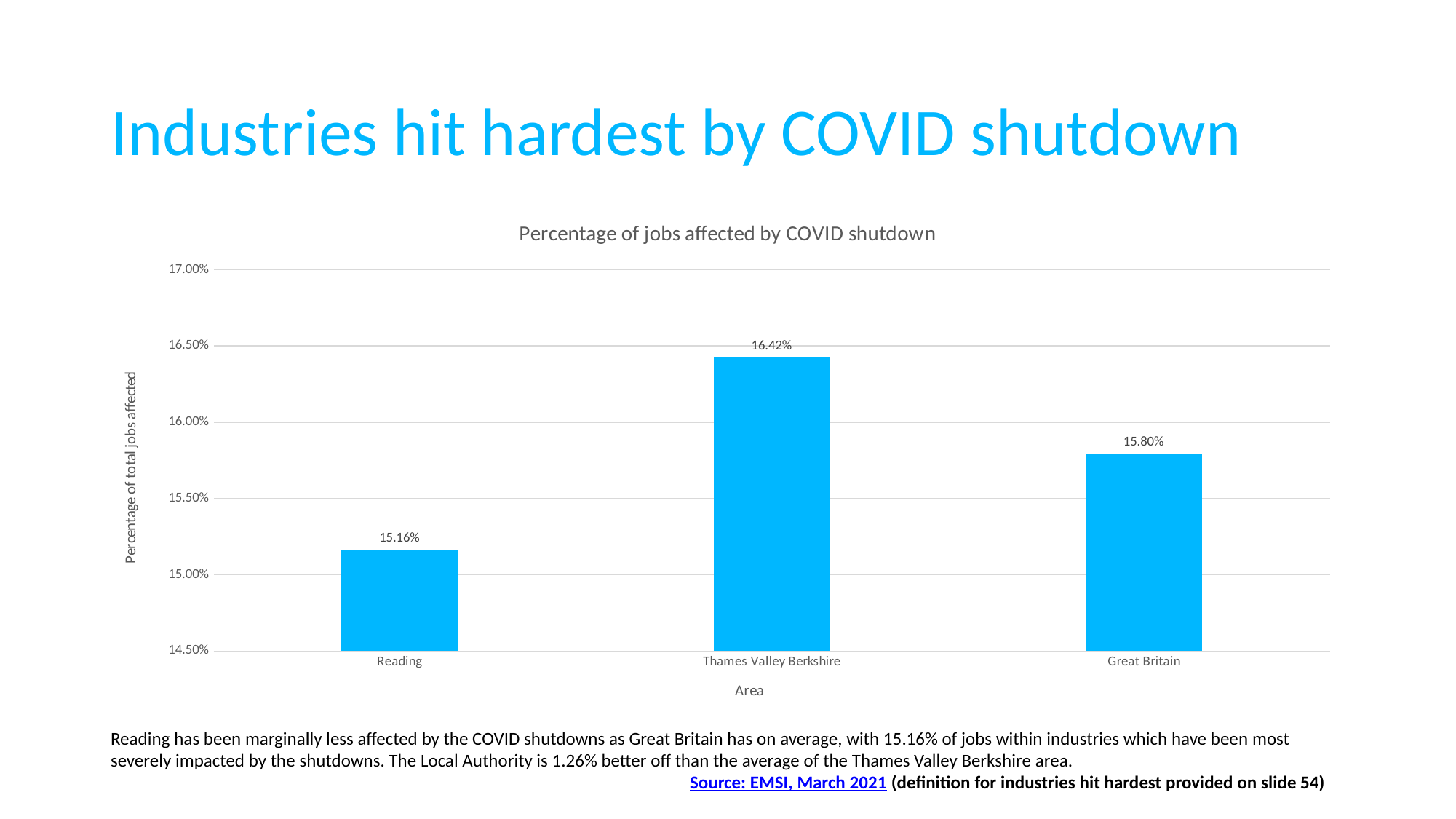
What is the title of the chart? Percentage of jobs affected by COVID shutdown What is the value for Great Britain? 15.80% What kind of chart is shown? Bar chart What is the difference between the values for Thames Valley Berkshire and Reading? 1.26% What is the value for Thames Valley Berkshire? 16.42% Which is larger, the value for Great Britain or the value for Reading? Great Britain How many areas are shown on the chart? 3 Is the value for Thames Valley Berkshire greater or less than 16.00%? greater Which area has the lowest percentage of jobs affected? Reading What is the value for Reading? 15.16% Which area has the highest percentage of jobs affected? Thames Valley Berkshire What is the difference between the values for Great Britain and Reading? 0.64%